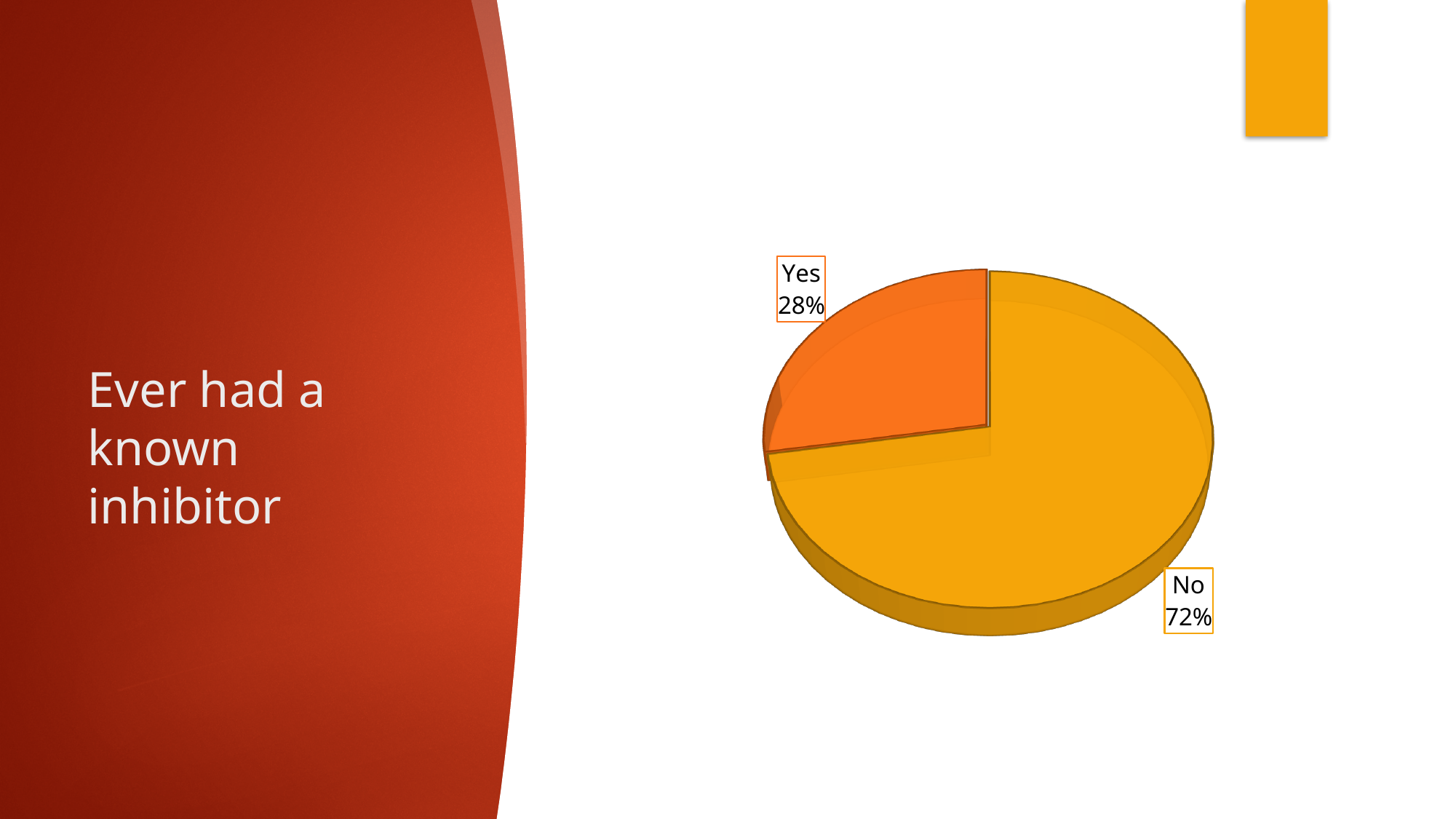
Which slice is larger, "Yes" or "No"? No Which slice of the pie chart is the largest? No Which slice of the pie chart is the smallest? Yes What share of the pie does the "No" slice represent? 72% How many slices does the pie chart have? 2 What kind of chart is shown on the slide? Pie chart What is the title text shown on the slide next to the chart? Ever had a known inhibitor What is the difference in percentage points between the "No" slice and the "Yes" slice? 44 What percentage of the pie chart is labelled "Yes"? 28% What percentage of the pie chart is labelled "No"? 72% What colour is the "Yes" slice of the pie chart? Orange